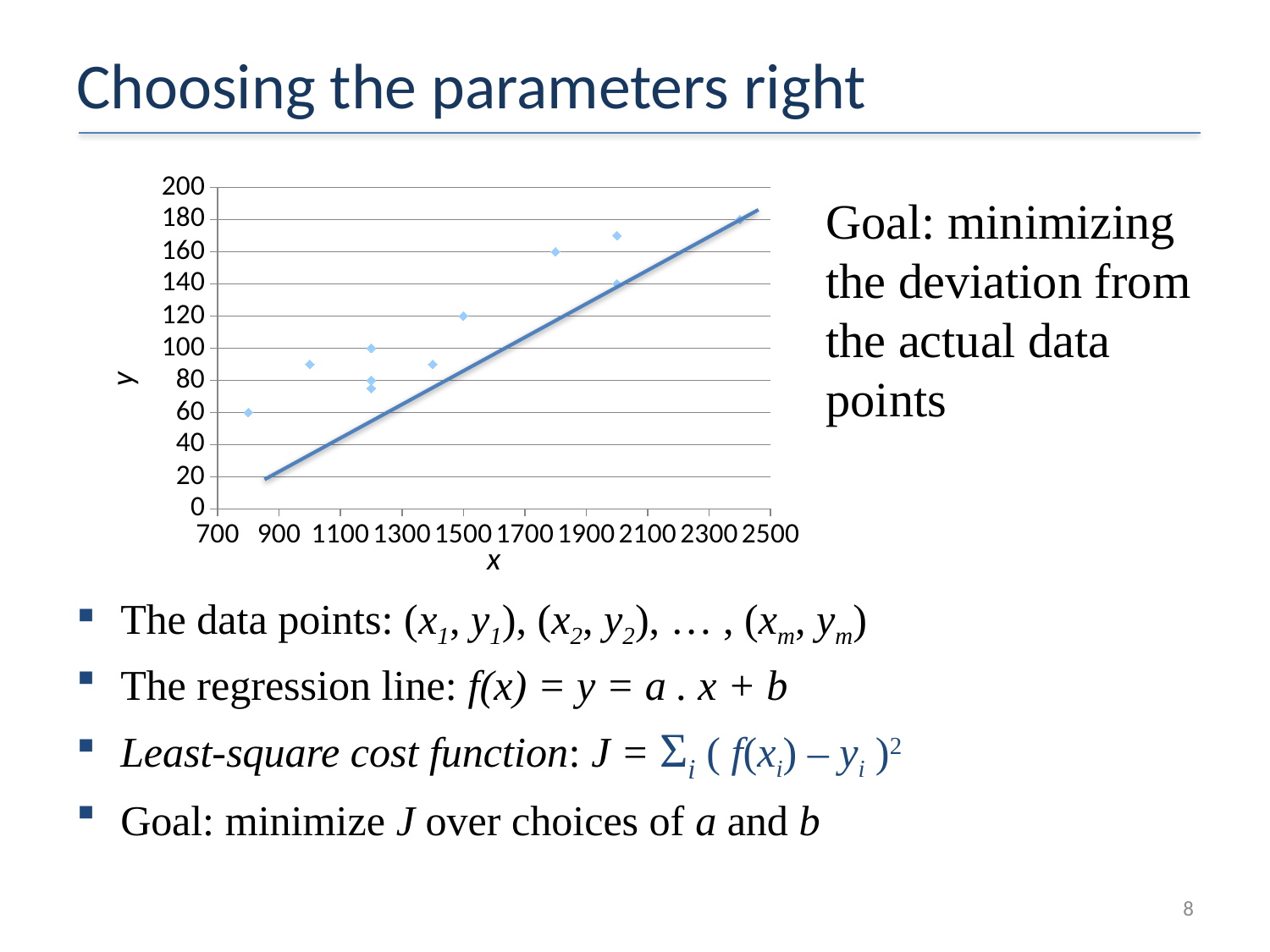
What kind of chart is shown on the slide? scatter chart Which data point has the lowest y value: the one at x = 800 or the one at x = 1800? the one at x = 800 What is the label of the vertical axis of the chart? y Is the y value of the data point at x = 1500 greater or less than 100? greater Is the y value of the data point at x = 1800 greater or less than 140? greater Is the y value of the data point at x = 1000 greater or less than 100? less Do the plotted data points generally rise or fall as x increases? rise What is the highest value shown on the vertical axis of the chart? 200 What is the label of the horizontal axis of the chart? x